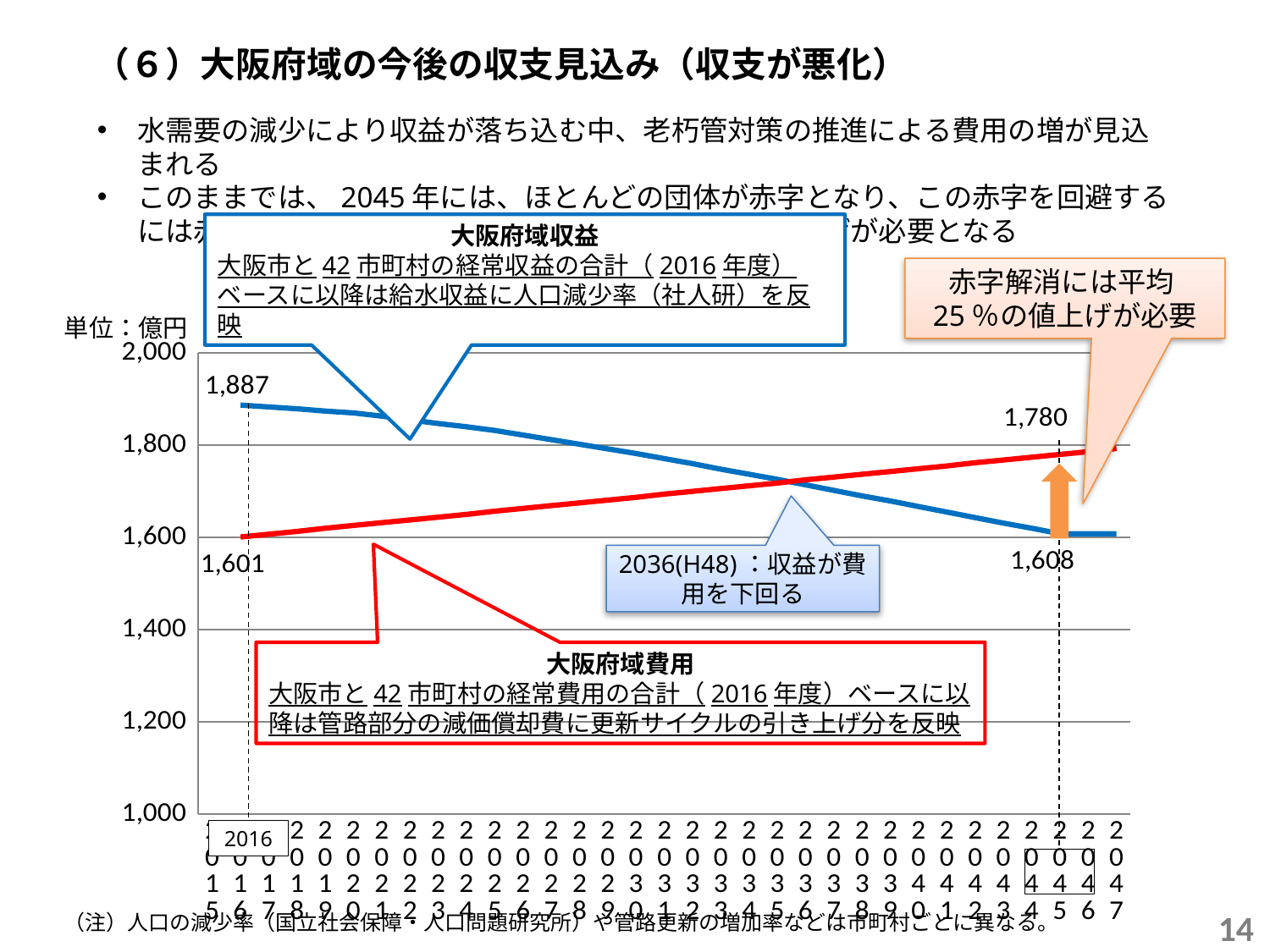
What is the difference between 大阪府域費用 and 大阪府域収益 in 2045? 172 In which year does the chart indicate that 収益 falls below 費用? 2036 What is the value of 大阪府域収益 (the blue line) in 2016? 1,887 What type of chart is shown on the slide? line chart What is the difference between 大阪府域収益 and 大阪府域費用 in 2016? 286 Does the 大阪府域収益 (blue) line rise or fall from 2016 to 2045? fall What is the value of 大阪府域費用 (the red line) in 2016? 1,601 Is the value of 大阪府域費用 (the red line) in 2030 greater or less than 1,600? greater In 2016, which is larger: 大阪府域収益 or 大阪府域費用? 大阪府域収益 What is the value of 大阪府域費用 (the red line) in 2045? 1,780 In 2045, which is larger: 大阪府域収益 or 大阪府域費用? 大阪府域費用 What is the value of 大阪府域収益 (the blue line) in 2045? 1,608